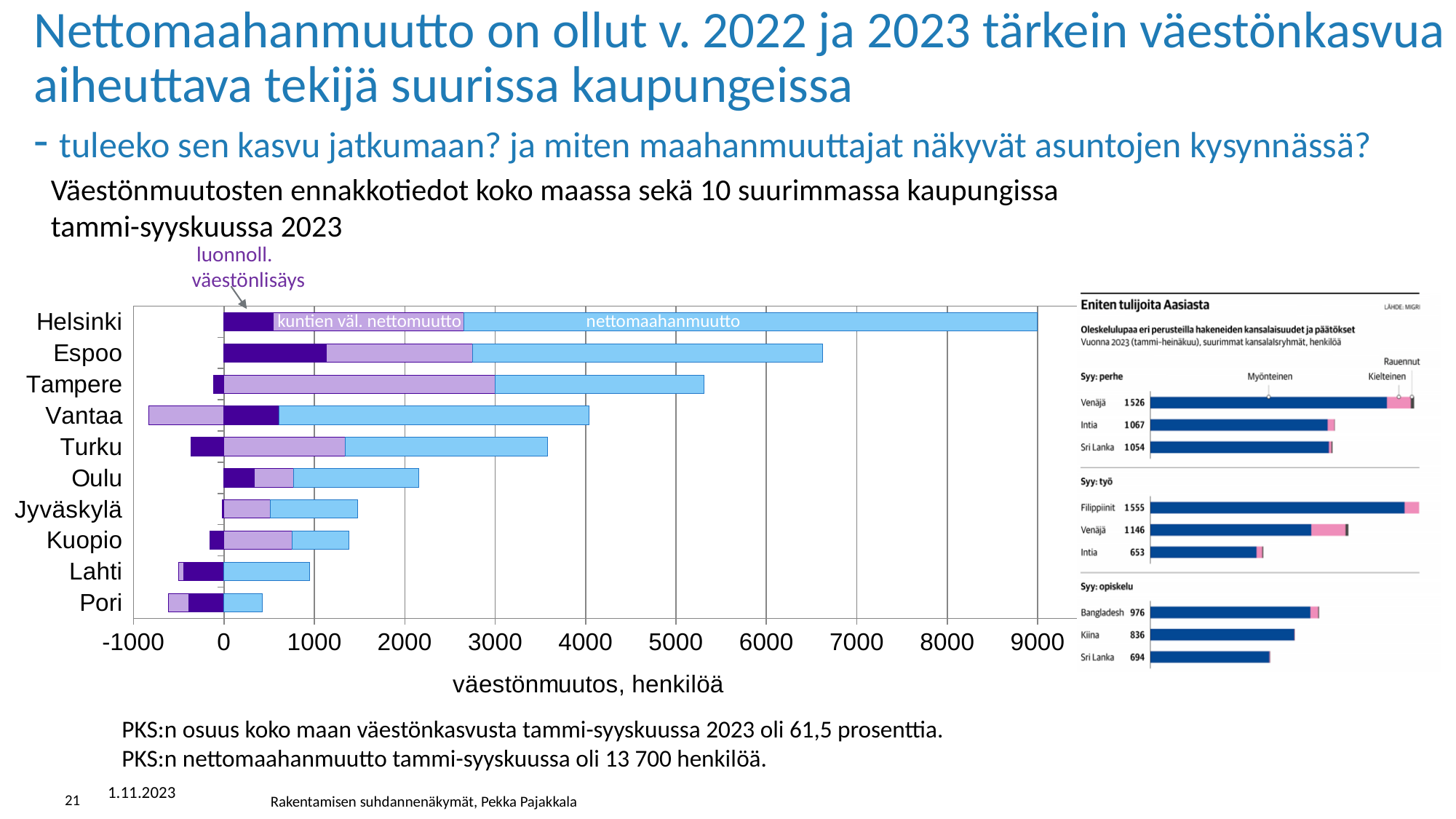
In the right chart 'Eniten tulijoita Aasiasta', what is the difference between Filippiinit and Venäjä under Syy: työ? 409 In the right chart 'Eniten tulijoita Aasiasta', what is the value for Venäjä under Syy: perhe? 1 526 In the left chart, which city's bar extends further to the right, Turku or Oulu? Turku In the left chart, which city has the longest nettomaahanmuutto bar? Helsinki What kind of chart is the large chart on the left of the slide? bar chart In the left chart, is the end of the Pori bar greater or less than 1000? less In the left chart, how many cities are listed on the vertical axis? 10 In the left chart, is the end of the Espoo bar greater or less than 6000? greater What is the x-axis title of the left chart? väestönmuutos, henkilöä In the left chart, how many series (bar segments) are labelled? 3 In the left chart, is the end of the Tampere bar greater or less than 5000? greater In the right chart 'Eniten tulijoita Aasiasta', which nationality has the highest value under Syy: opiskelu? Bangladesh